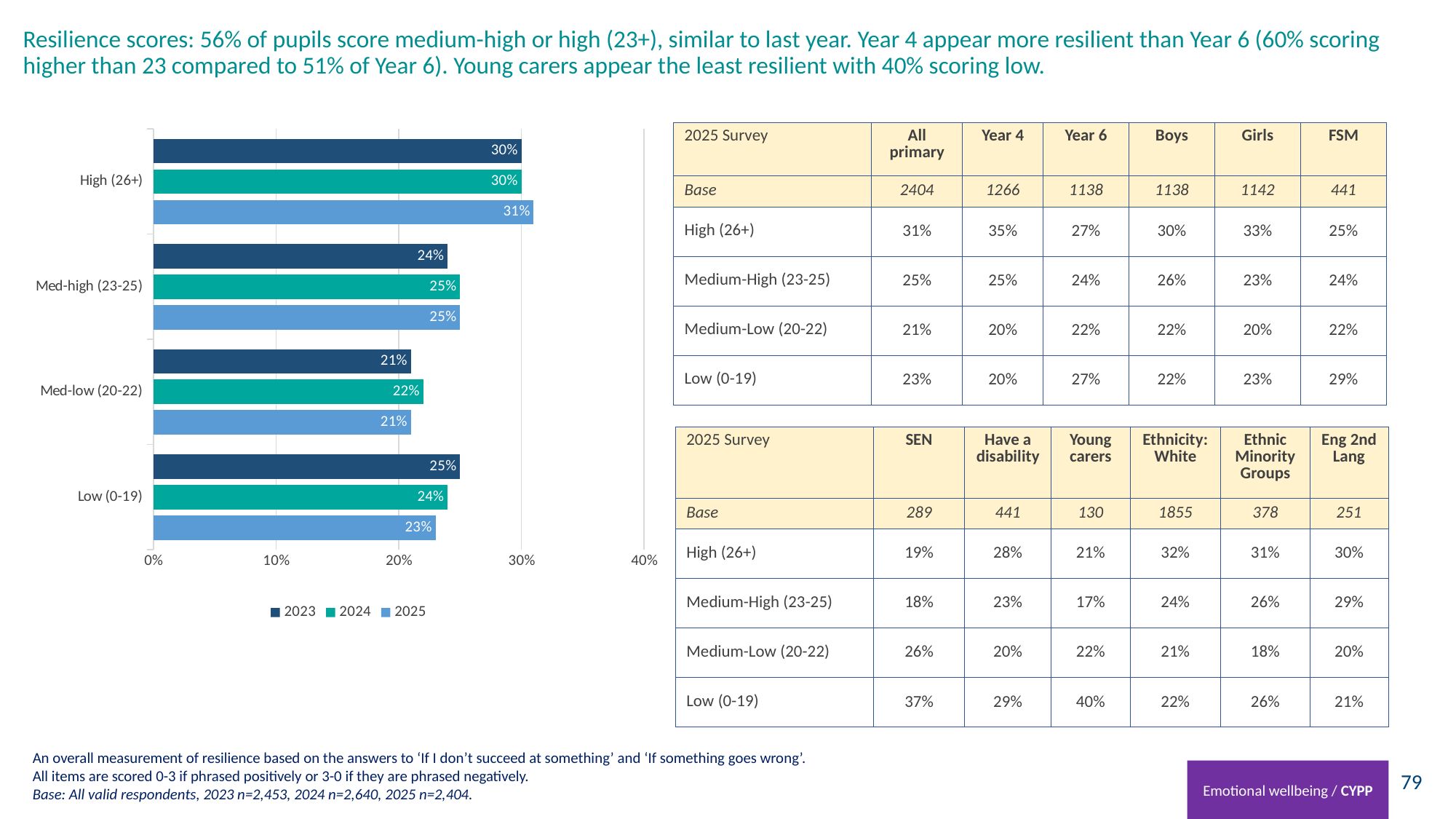
What is the 2025 value for High (26+)? 31% Which category has the lowest 2023 value? Med-low (20-22) What is the 2023 value for Low (0-19)? 25% How many categories are shown on the chart? 4 Which category has the highest 2025 value? High (26+) What is the difference between the 2023 and 2025 values for Low (0-19)? 2% How many series does the chart legend list? 3 What kind of chart is shown on the slide? Bar chart What is the 2024 value for Med-low (20-22)? 22% Did the Low (0-19) value rise or fall from 2023 to 2025? Fall Which is larger for Med-high (23-25): the 2023 value or the 2024 value? 2024 Which series is shown in the darkest blue colour in the legend? 2023